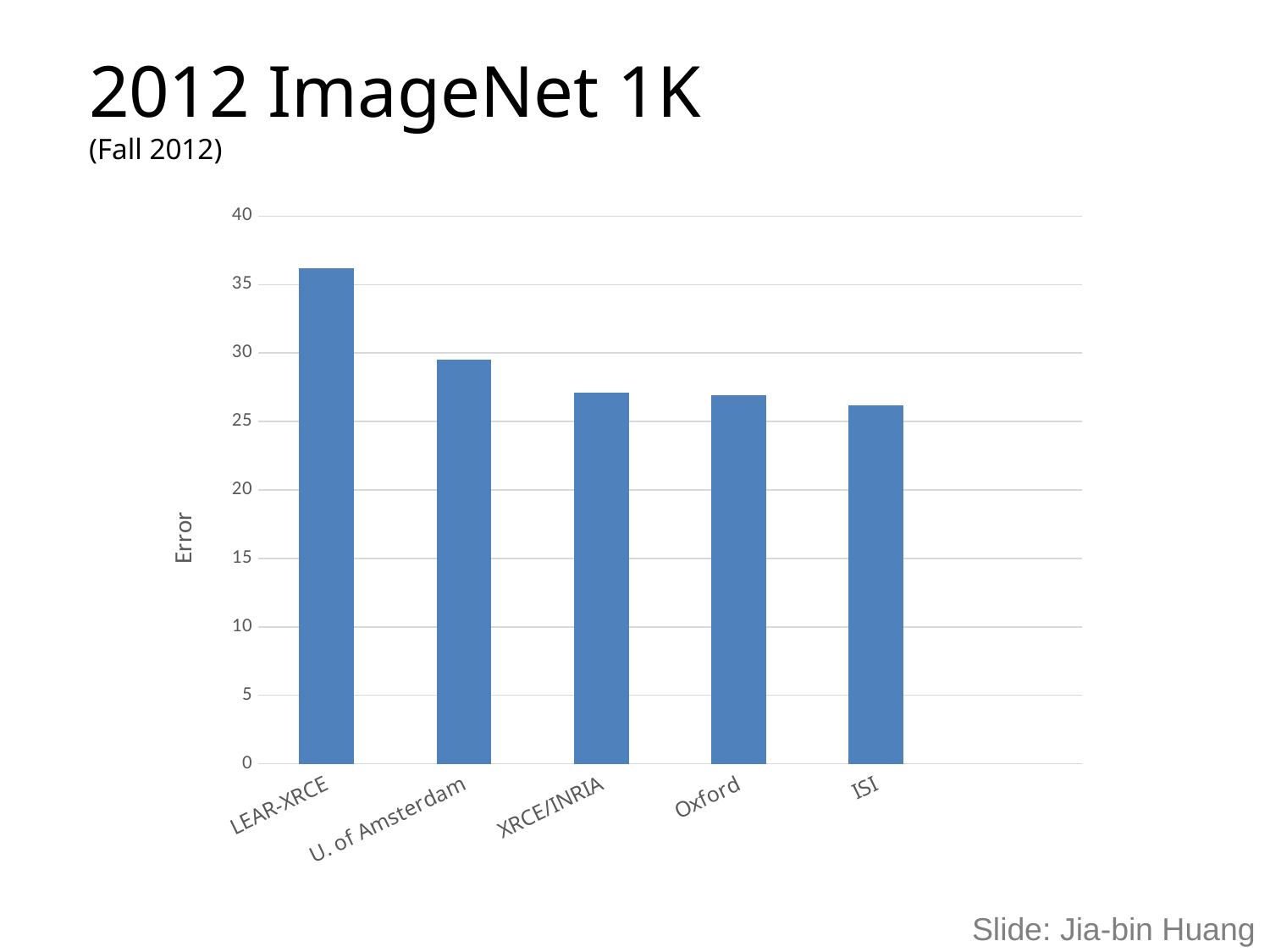
Do the error values rise or fall moving from left to right along the x axis? fall Is the error for Oxford greater or less than 25? greater Which category has the highest error in the chart? LEAR-XRCE What is the label on the vertical axis of the chart? Error Is the error for LEAR-XRCE greater or less than 35? greater Is the error for U. of Amsterdam greater or less than 30? less What kind of chart is shown on the slide? bar chart Which has a higher error, LEAR-XRCE or U. of Amsterdam? LEAR-XRCE Which has a lower error, U. of Amsterdam or ISI? ISI How many categories (teams) are shown on the x axis of the chart? 5